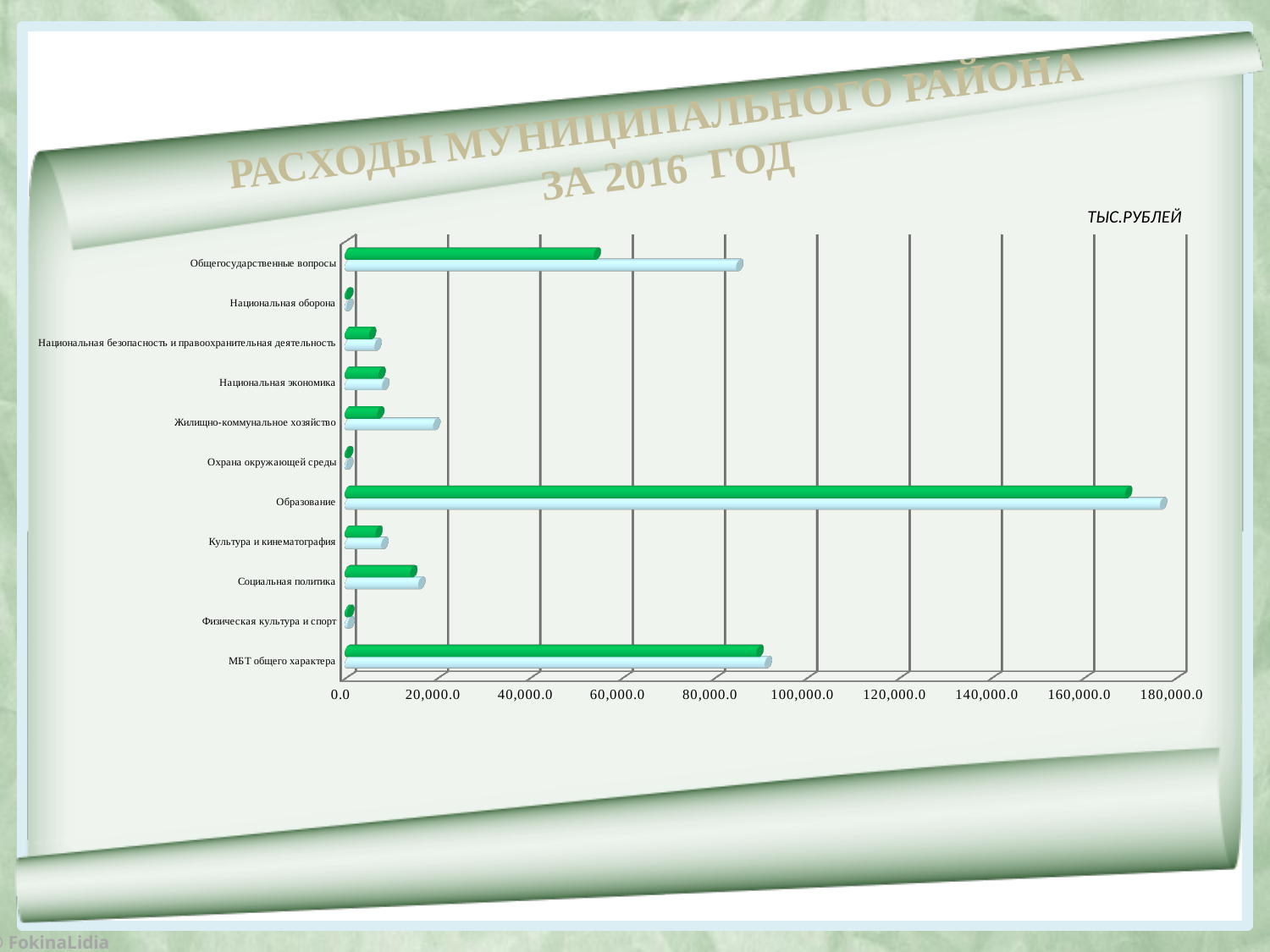
Is the green bar for Общегосударственные вопросы greater or less than 60,000.0? less Is the green bar for МБТ общего характера greater or less than 80,000.0? greater Is the light blue bar for Общегосударственные вопросы greater or less than 80,000.0? greater How many expenditure categories are listed on the vertical axis of the chart? 11 Which is larger, the green bar for Общегосударственные вопросы or the green bar for Социальная политика? Общегосударственные вопросы Which is larger, the green bar for Образование or the green bar for МБТ общего характера? Образование What type of chart is shown on the slide? bar chart What is the title of the chart on the slide? РАСХОДЫ МУНИЦИПАЛЬНОГО РАЙОНА ЗА 2016 ГОД Which category has the highest value in the chart? Образование In what units are the values on the chart expressed, according to the label above the chart? ТЫС.РУБЛЕЙ